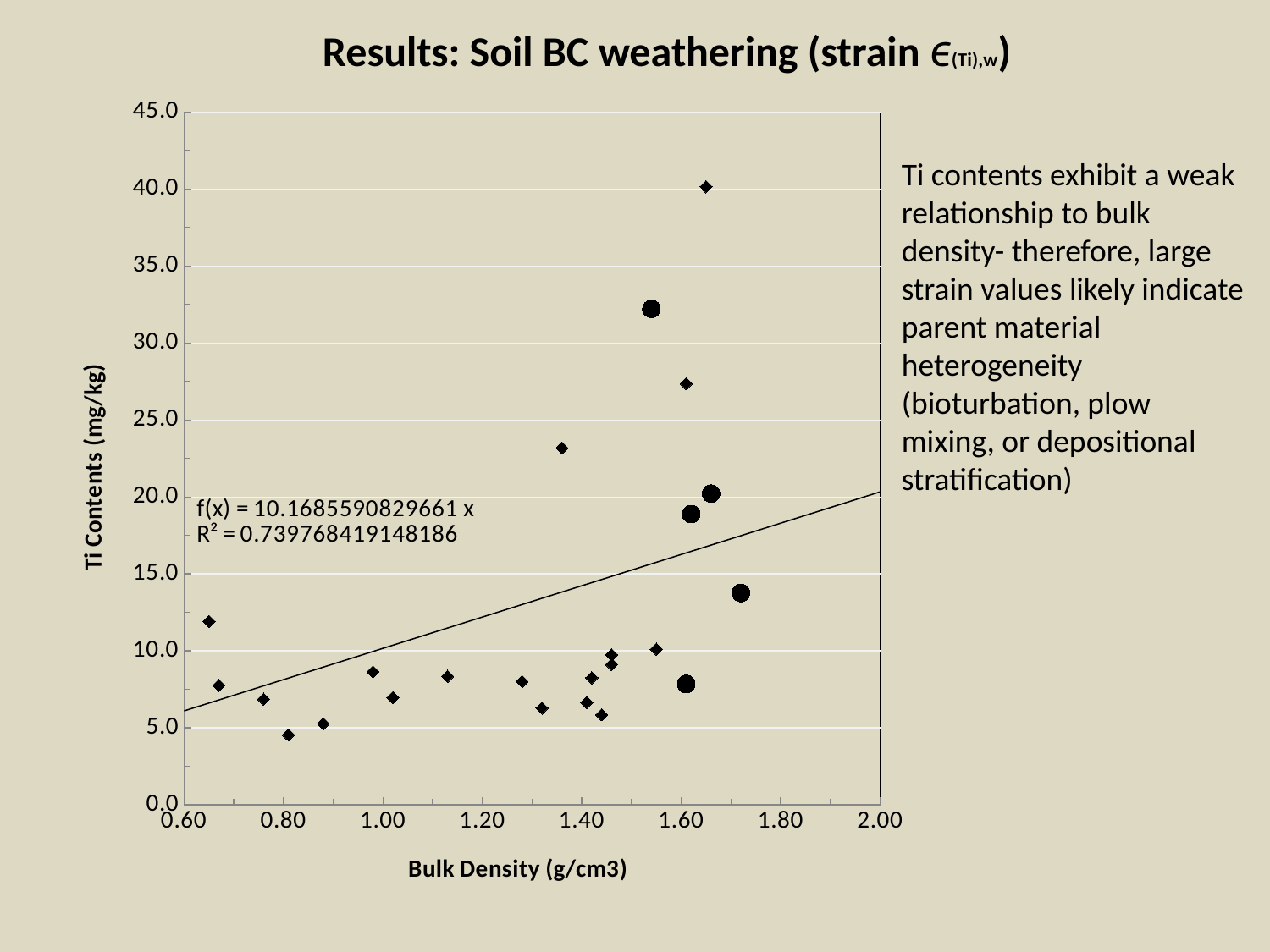
What R² value is printed on the chart? 0.739768419148186 What is the minimum value shown on the x axis? 0.60 What is the maximum value shown on the x axis? 2.00 What is the title of the chart's x axis? Bulk Density (g/cm3) Does the fitted trendline rise or fall as bulk density increases? rise Is the highest plotted Ti content value greater or less than 35.0? greater Is the lowest plotted Ti content value greater or less than 5.0? less What kind of chart is shown on the slide? scatter chart What is the trendline equation printed on the chart? f(x) = 10.1685590829661 x What is the maximum value shown on the y axis? 45.0 What is the title of the chart's y axis? Ti Contents (mg/kg)